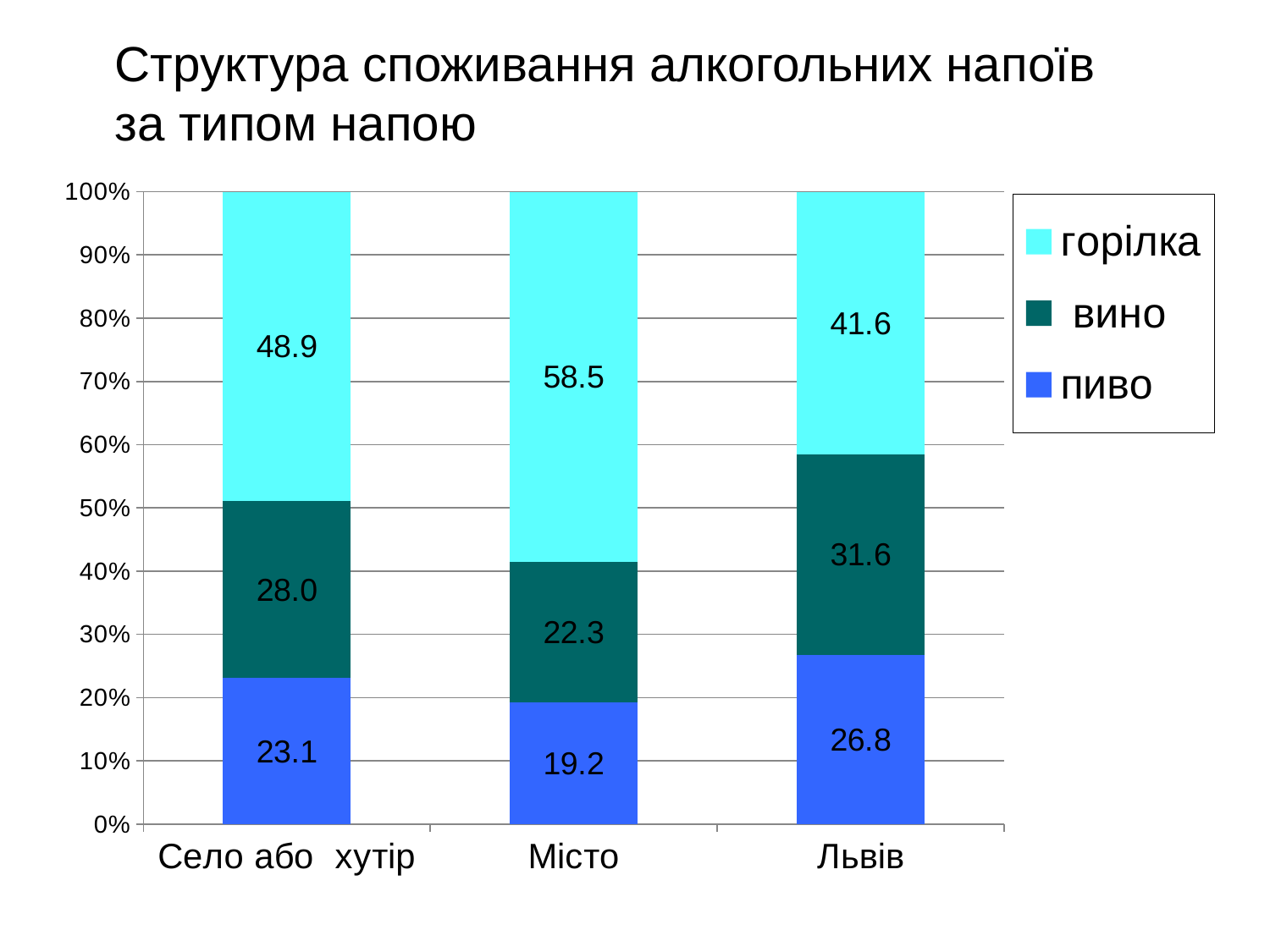
What is the value for вино in Село або хутір? 28.0 What kind of chart is shown on the slide? Stacked bar chart How many categories are shown on the x axis? 3 Which category has the highest value for горілка? Місто How many series does the legend list? 3 What is the title of the chart? Структура споживання алкогольних напоїв за типом напою Which series is shown in the lightest (cyan) colour? горілка What is the value for горілка in Місто? 58.5 What is the value for пиво in Львів? 26.8 Which category has the lowest value for пиво? Місто Which is larger: the пиво value for Село або хутір or for Львів? Львів What is the difference between the вино values for Львів and Місто? 9.3